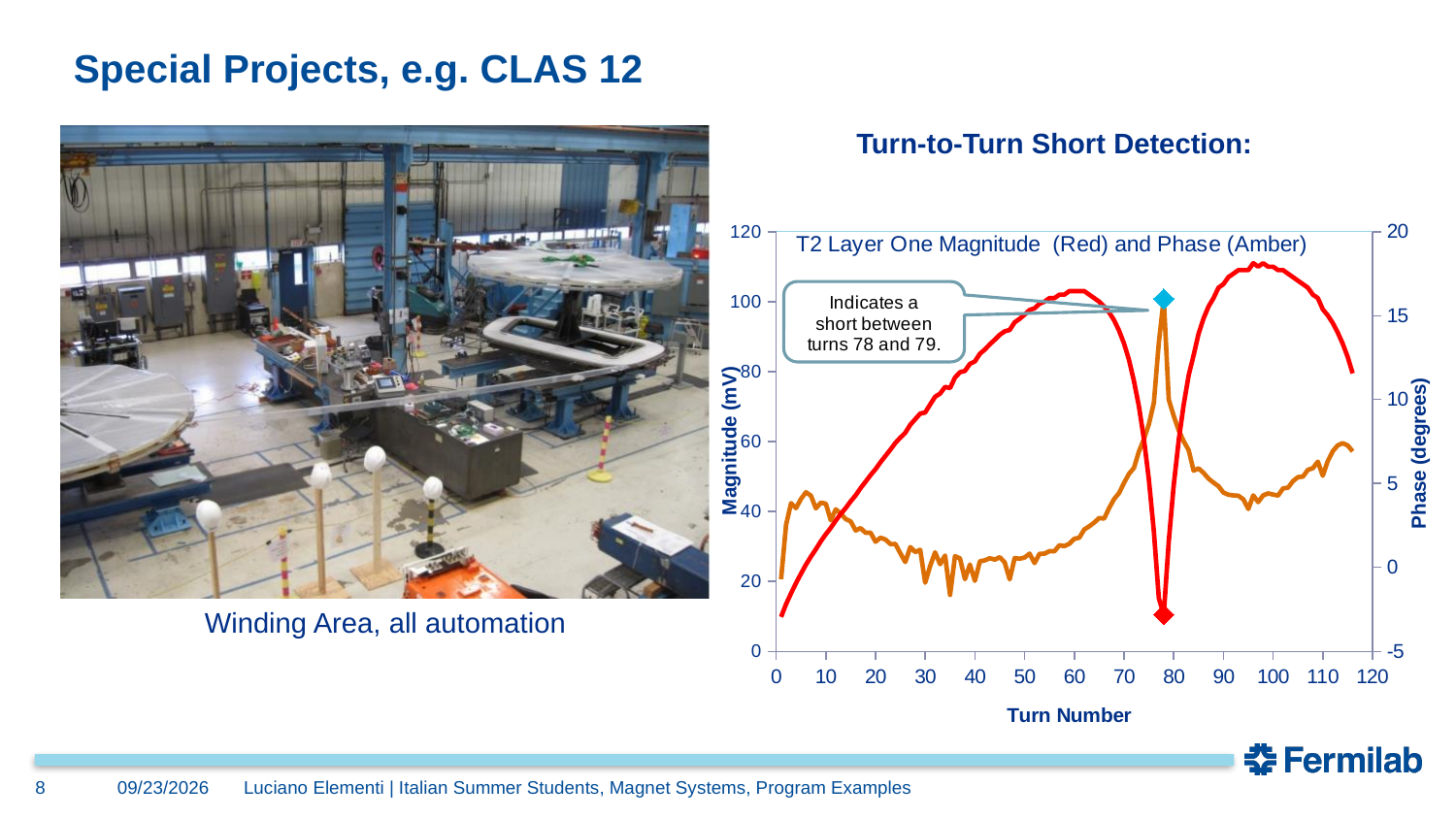
Does the Magnitude (red) line rise or fall between turn 0 and turn 60? rise What kind of chart is shown on the slide? line chart Is the Magnitude value at turn 100 greater or less than 100 mV? greater Does the Phase (amber) line rise or fall between turn 10 and turn 30? fall Between which turns does the annotation indicate a short? turns 78 and 79 Is the Magnitude value at turn 78 greater or less than 20 mV? less How many data series are plotted in the chart? 2 Is the Magnitude value at turn 30 greater or less than 60 mV? greater What is the title of the chart? T2 Layer One Magnitude (Red) and Phase (Amber)